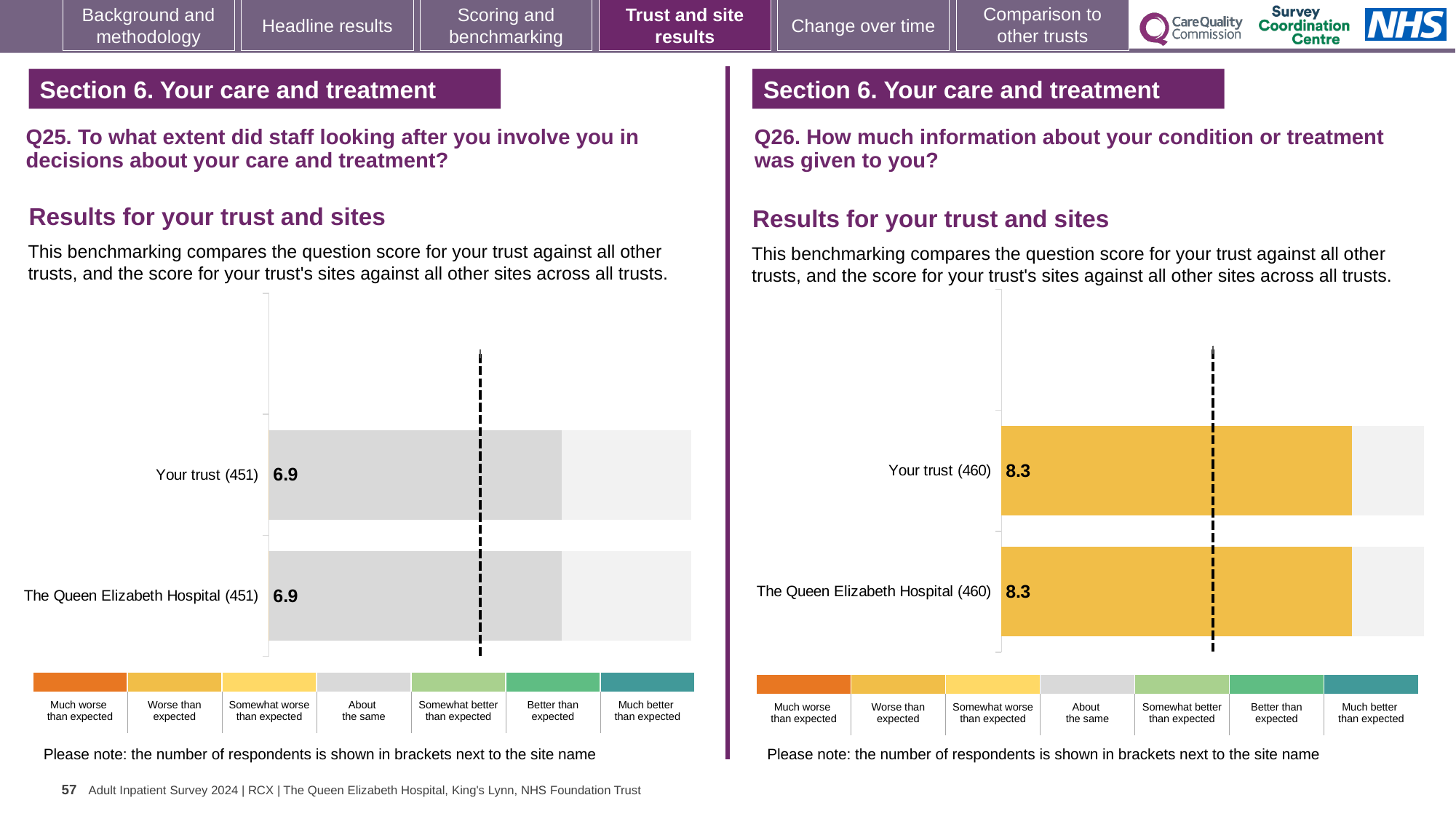
How many bars are plotted on the Q26 chart (right)? 2 On the Q25 chart (left), what is the score for Your trust? 6.9 How many bars are plotted on the Q25 chart (left)? 2 On the Q25 chart (left), what is the score for The Queen Elizabeth Hospital? 6.9 What kind of chart is used on the Q25 chart (left)? Bar chart On the Q26 chart (right), what is the score for The Queen Elizabeth Hospital? 8.3 On the Q26 chart (right), what is the difference between the score for Your trust and the score for The Queen Elizabeth Hospital? 0.0 On the Q25 chart (left), how many respondents are shown in brackets for Your trust? 451 On the Q26 chart (right), which benchmark category does the bar colour correspond to in the legend? Worse than expected On the Q25 chart (left), what is the difference between the score for Your trust and the score for The Queen Elizabeth Hospital? 0.0 On the Q26 chart (right), what is the score for Your trust? 8.3 On the Q26 chart (right), how many respondents are shown in brackets for The Queen Elizabeth Hospital? 460